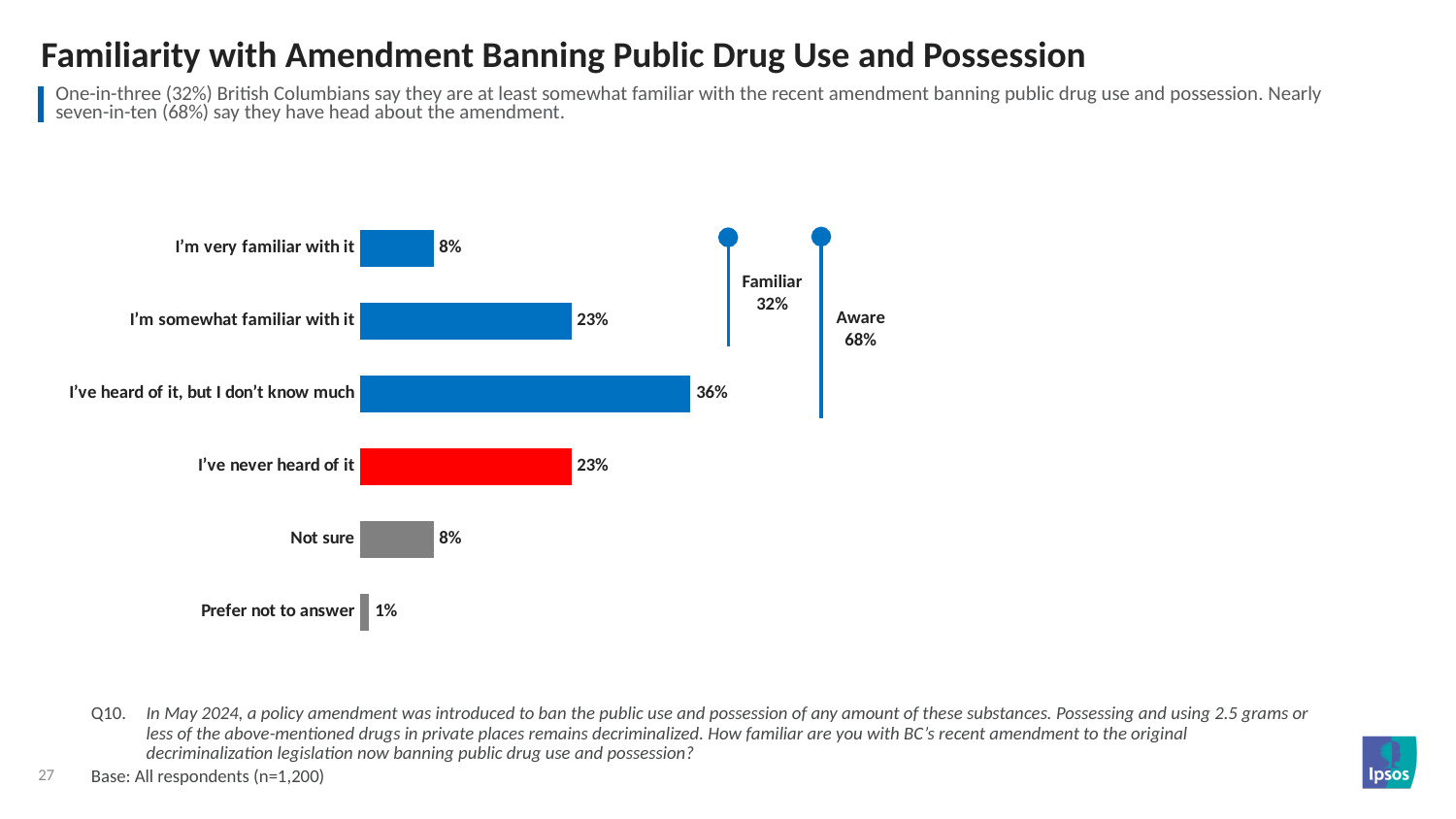
Which response category has the lowest percentage? Prefer not to answer What is the combined 'Familiar' percentage shown on the chart? 32% What percentage of respondents chose 'Prefer not to answer'? 1% How many response categories are shown in the bar chart? 6 What percentage of respondents say they have never heard of it? 23% What percentage of respondents say they are very familiar with the amendment? 8% What is the difference between the percentage who have heard of it but don't know much and the percentage who are somewhat familiar with it? 13 percentage points What type of chart is used on this slide? Bar chart Which response category has the highest percentage? I've heard of it, but I don't know much Which is larger: the percentage who are somewhat familiar with it or the percentage who are very familiar with it? I'm somewhat familiar with it What percentage of respondents say they have heard of it but don't know much? 36% Which bar is coloured red? I've never heard of it